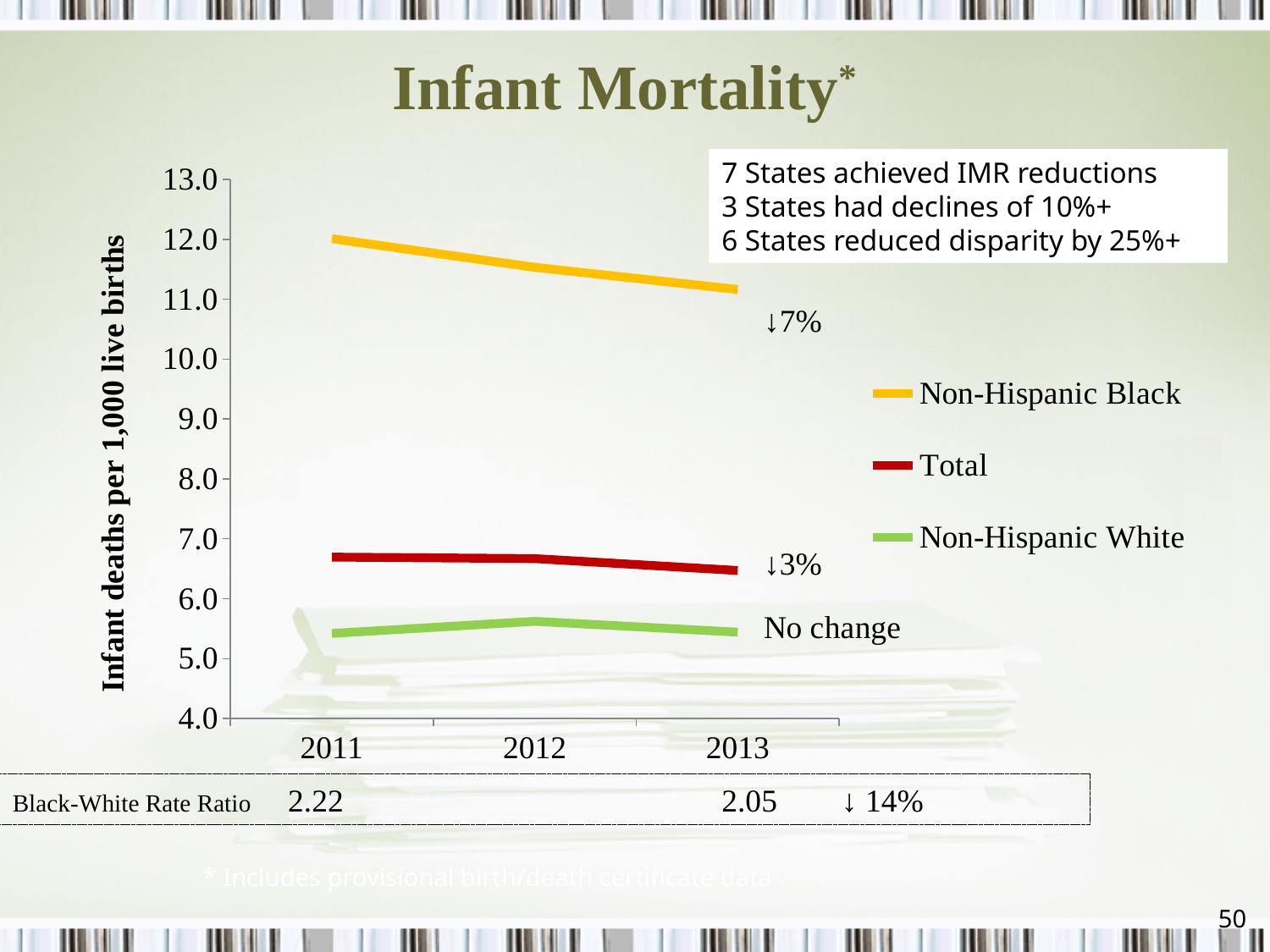
What is the label on the y axis? Infant deaths per 1,000 live births Is the Non-Hispanic White value in 2011 greater or less than 6.0? less What is the Black-White Rate Ratio shown for 2013? 2.05 How many series does the legend list? 3 Is the Non-Hispanic Black value in 2013 greater or less than 10.0? greater Which series has the highest infant mortality rate across all years? Non-Hispanic Black What kind of chart is shown on the slide? line chart What percentage change is annotated for the Non-Hispanic Black line? ↓7% Which series has the lowest infant mortality rate across all years? Non-Hispanic White Is the Total value in 2011 greater or less than 6.0? greater How many years are shown on the x axis? 3 Does the Non-Hispanic Black line rise or fall from 2011 to 2013? fall